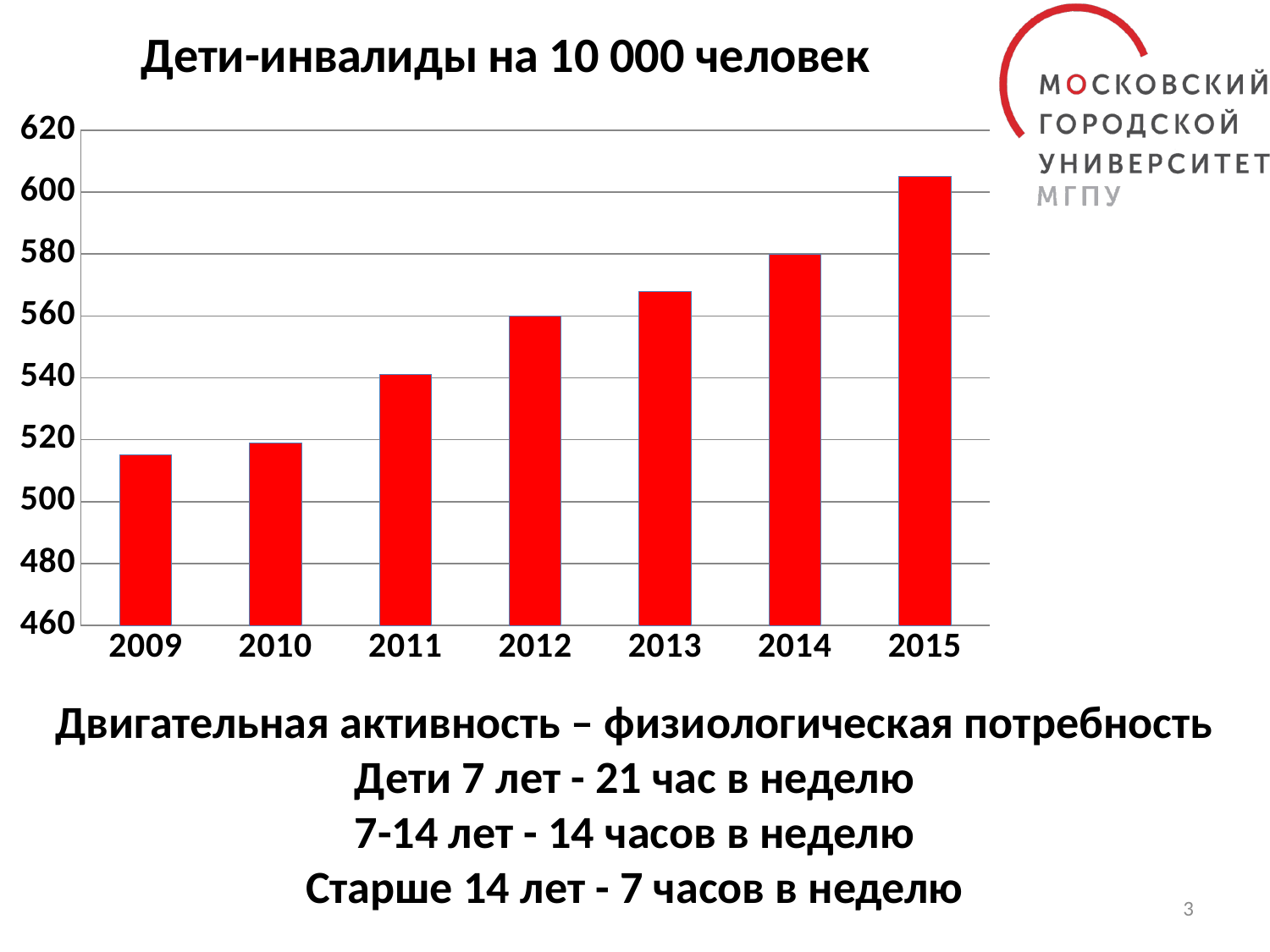
Is the value for 2009 greater or less than 520? less Is the value for 2014 greater or less than 600? less How many years are shown on the x axis of the chart? 7 Do the values rise or fall from 2009 to 2015? rise What is the title of the chart? Дети-инвалиды на 10 000 человек Is the value for 2015 greater or less than 600? greater Which year has the lowest value in the chart? 2009 Which year has the highest value in the chart? 2015 Which year has the larger value, 2011 or 2014? 2014 What colour are the bars in the chart? red What kind of chart is shown on the slide? bar chart